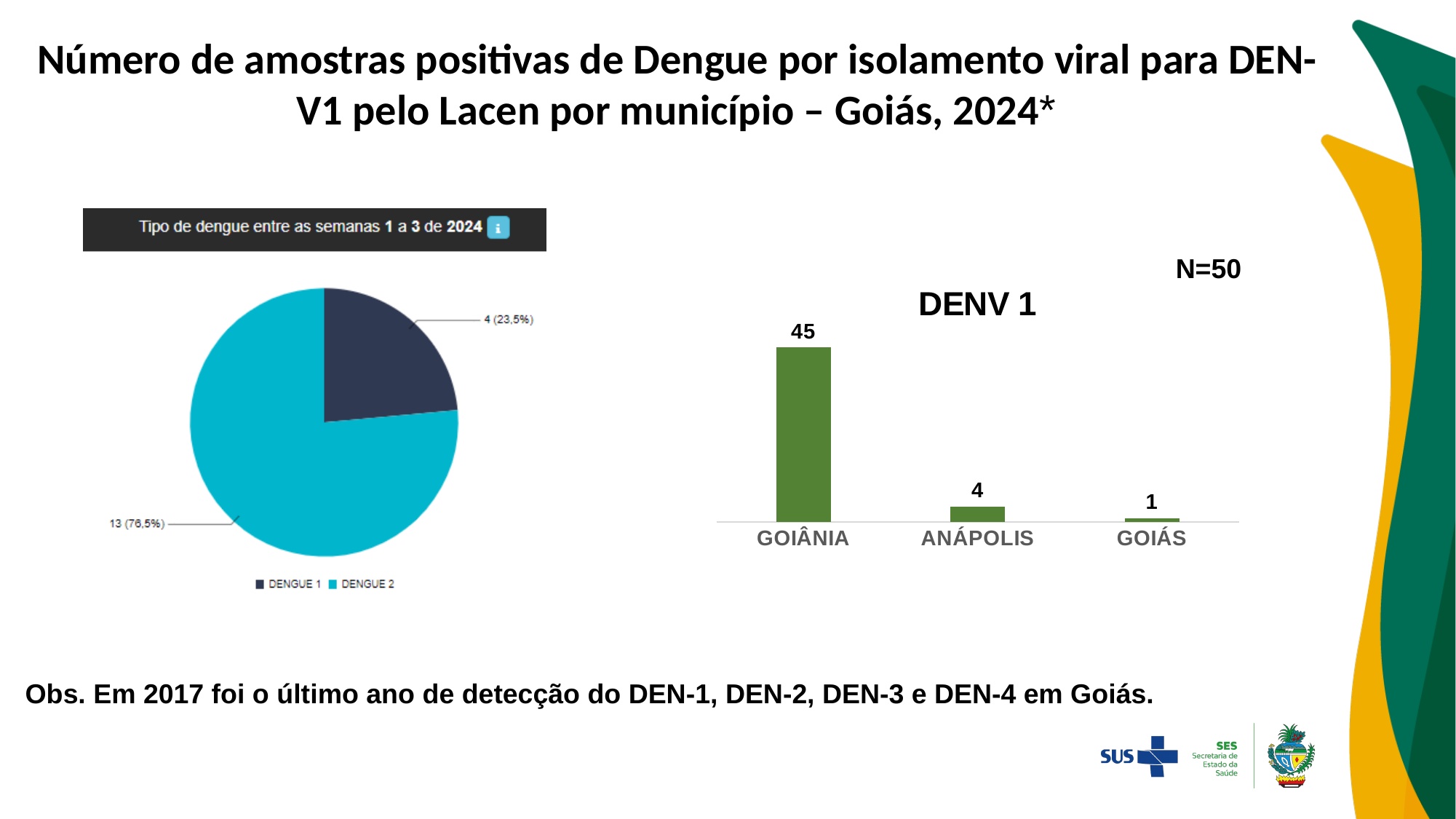
In the pie chart on the left, which slice is larger, DENGUE 1 or DENGUE 2? DENGUE 2 What is the title of the pie chart on the left? Tipo de dengue entre as semanas 1 a 3 de 2024 What kind of chart is the DENV 1 chart on the right? bar chart In the pie chart on the left, what share of the pie does DENGUE 1 represent? 23,5% In the DENV 1 bar chart, what is the difference between the values for GOIÂNIA and ANÁPOLIS? 41 In the DENV 1 bar chart, which category has the highest value? GOIÂNIA In the pie chart on the left, what is the value shown for DENGUE 2? 13 (76,5%) In the DENV 1 bar chart, what is the value for GOIÂNIA? 45 In the DENV 1 bar chart, how many categories are shown? 3 How many entries does the legend of the pie chart on the left list? 2 In the DENV 1 bar chart, what is the value for ANÁPOLIS? 4 In the DENV 1 bar chart, which category has the lowest value? GOIÁS